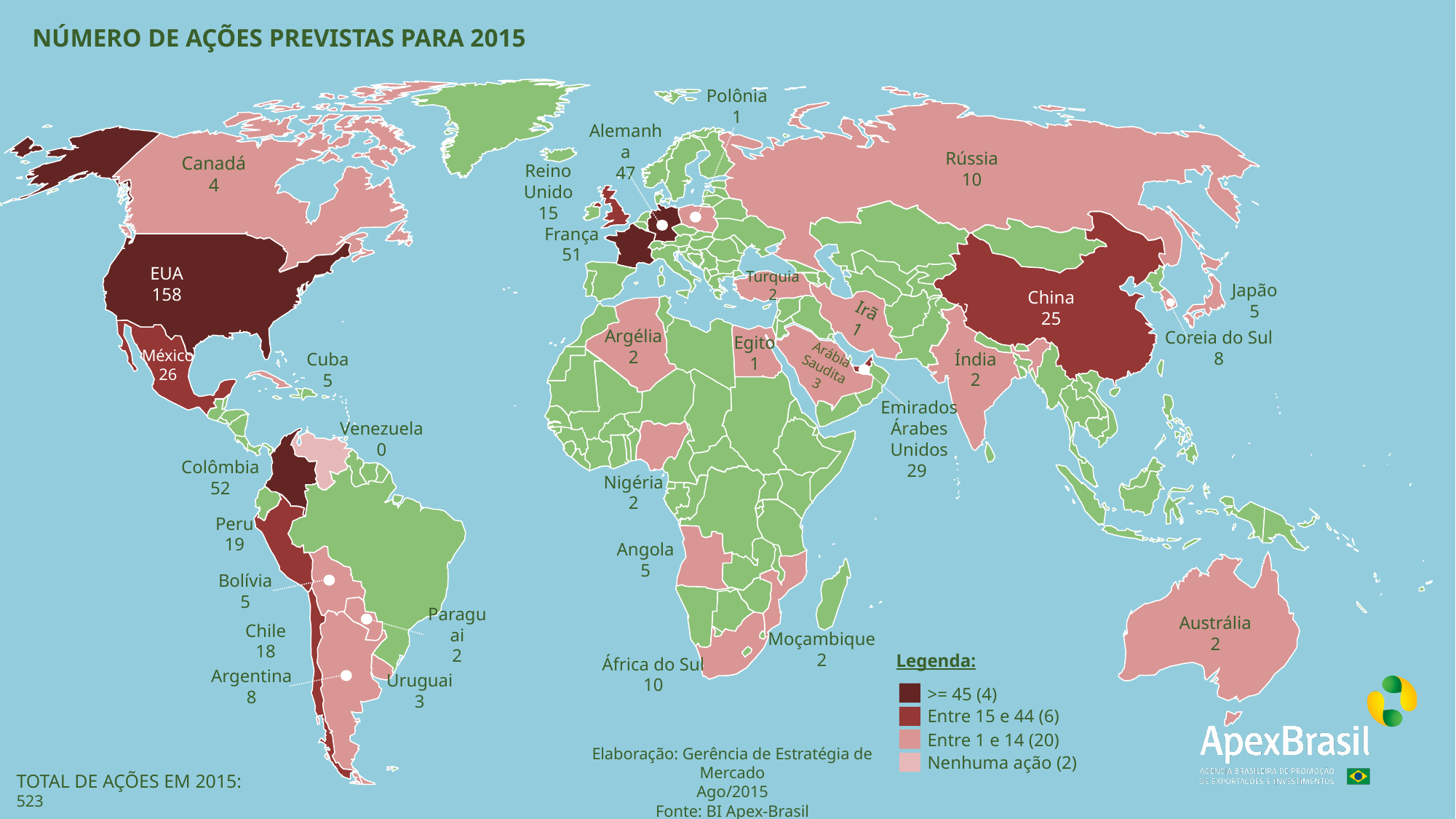
What kind of chart is shown on the slide? Map chart According to the legend, how many countries have 45 or more actions? 4 What is the total number of actions in 2015 shown on the slide? 523 What is the number of actions planned for 2015 for Colômbia? 52 Which country has the highest number of actions planned for 2015? EUA What is the number of actions planned for 2015 for EUA? 158 What is the number of actions planned for 2015 for Emirados Árabes Unidos? 29 How many categories does the legend list? 4 Which country shown on the map has the lowest number of actions planned for 2015? Venezuela What is the difference between the number of actions for França and Alemanha? 4 What is the title of the chart? NÚMERO DE AÇÕES PREVISTAS PARA 2015 Which has more actions planned for 2015, China or México? México